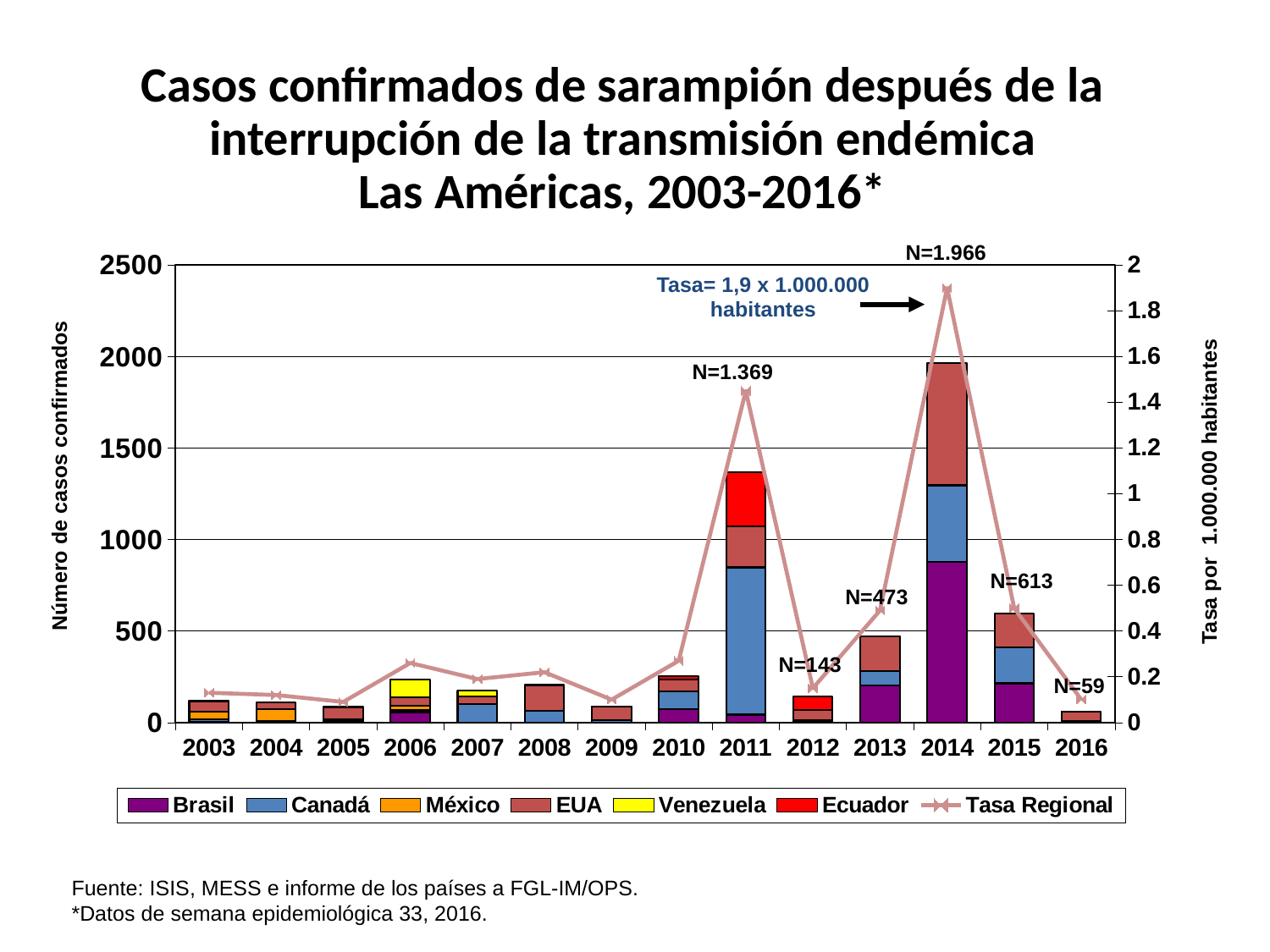
Which year has more confirmed cases, 2013 or 2015? 2015 How many years are shown on the x axis? 14 What is the difference between the total cases in 2013 and in 2012? 330 What is the regional rate (Tasa Regional) per 1.000.000 inhabitants in 2014? 1,9 Among the years 2011 to 2016, which year has the lowest total of confirmed cases? 2016 What is the difference between the total cases in 2014 and in 2011? 597 Is the Tasa Regional value for 2011 greater or less than 1? greater What is the total number of confirmed cases shown for 2011? 1.369 Do the total confirmed cases rise or fall from 2014 to 2016? fall Which year has the highest total of confirmed cases? 2014 What is the total number of confirmed cases shown for 2014? 1.966 How many entries does the legend list? 7